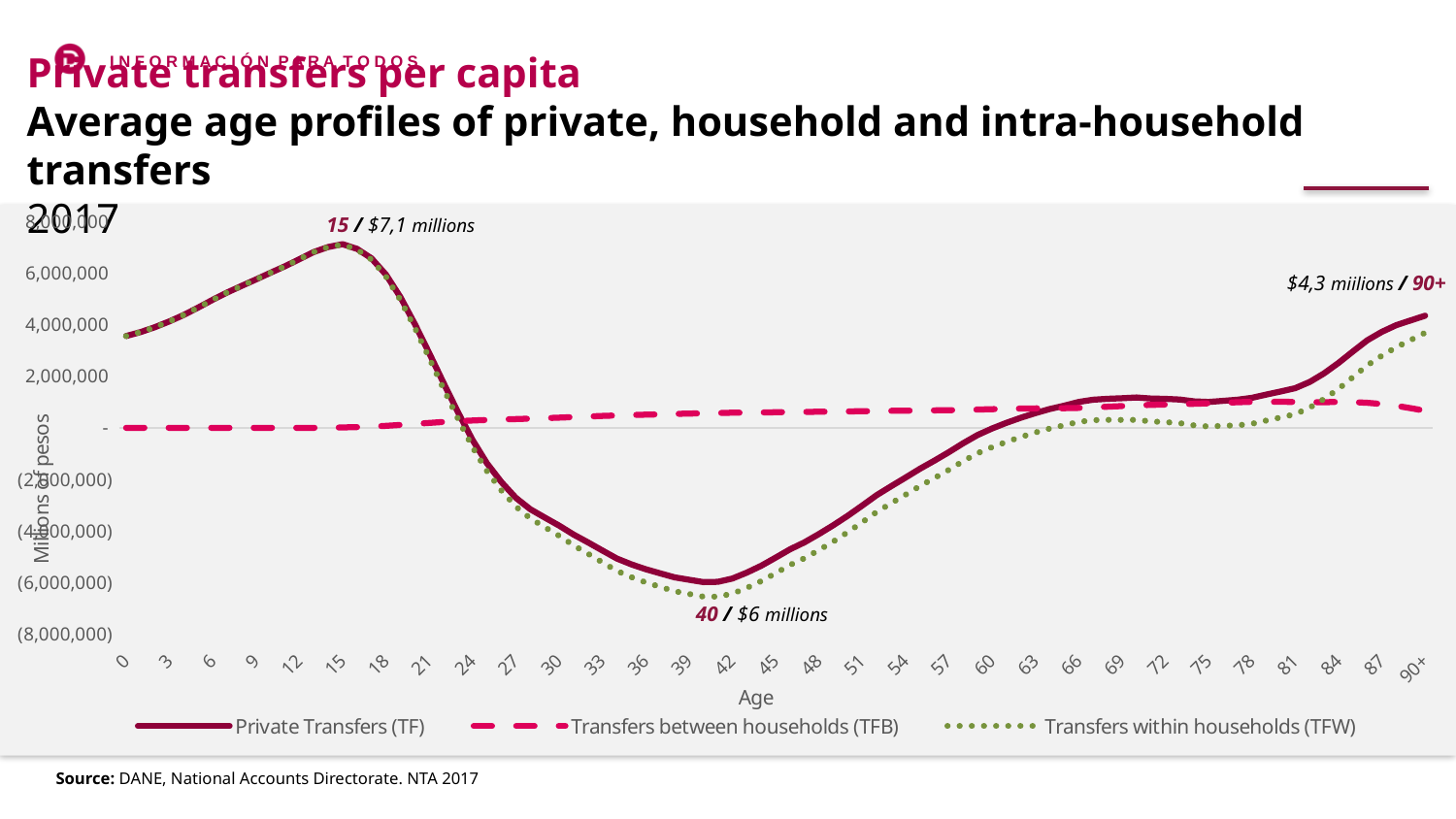
What kind of chart is shown on the slide? line chart According to the annotation, what is the value of private transfers at age 40? $6 millions According to the annotation, what is the value of private transfers at age 15? $7,1 millions At age 30, which is higher: Private Transfers (TF) or Transfers between households (TFB)? Transfers between households (TFB) At which age does the Private Transfers (TF) line reach its highest point? 15 According to the annotation, what is the value of private transfers at age 90+? $4,3 miilions Does the Private Transfers (TF) line rise or fall between age 15 and age 40? fall Is the value of Private Transfers (TF) at age 0 greater or less than 2,000,000? greater What is the label of the y axis? Millions of pesos At which age does the Private Transfers (TF) line reach its lowest point? 40 What is the label of the x axis? Age How many series does the legend list? 3